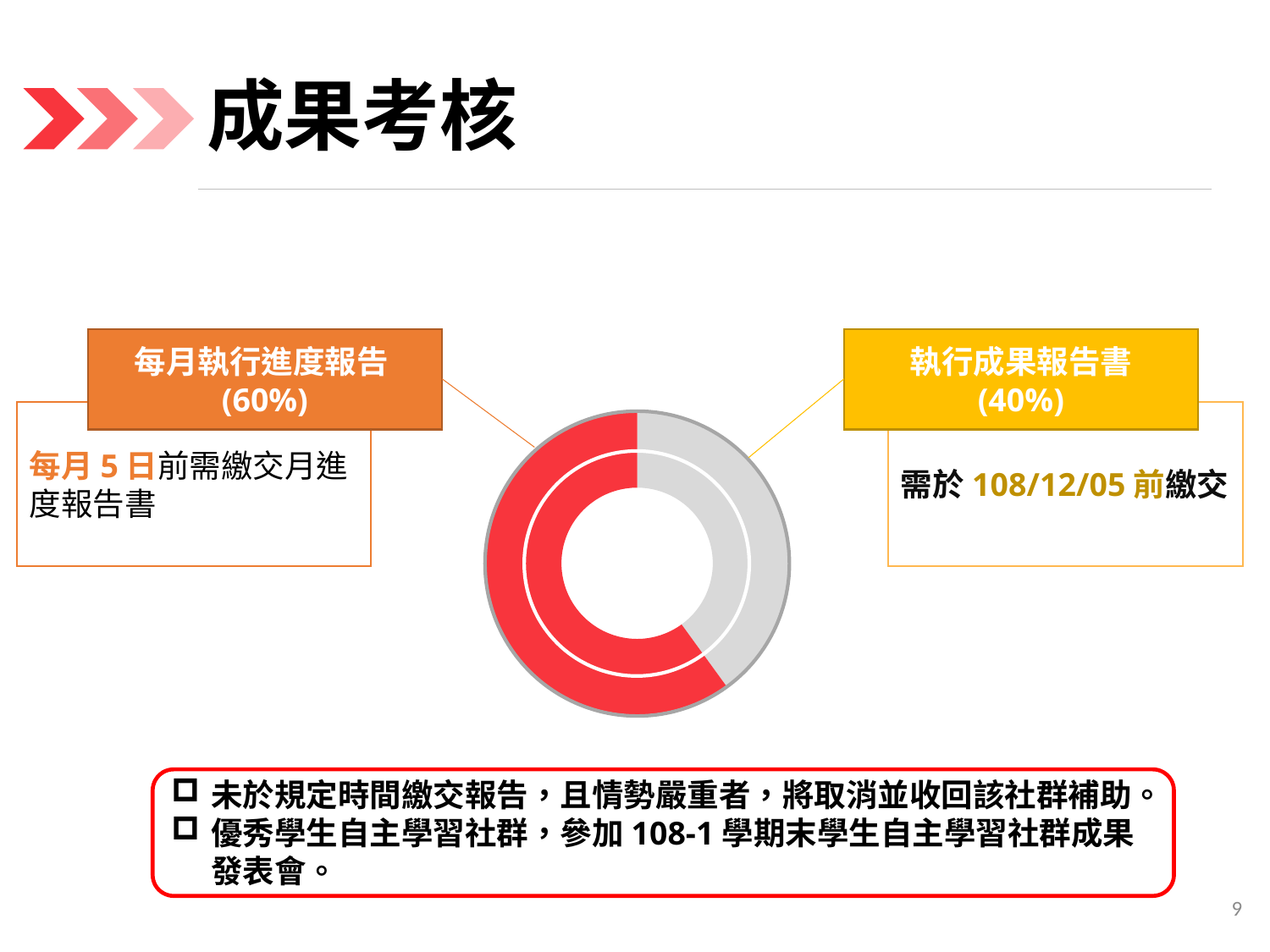
What is the difference in percentage points between 每月執行進度報告 and 執行成果報告書? 20 percentage points What colour is the segment representing 每月執行進度報告? Red What kind of chart is shown on the slide? Doughnut (pie) chart Which segment of the chart is the smallest? 執行成果報告書 What colour is the segment representing 執行成果報告書? Grey Is the share for 執行成果報告書 greater or less than 50%? less Which segment of the chart is the largest? 每月執行進度報告 What share of the chart does 每月執行進度報告 represent? 60% Which is larger, 每月執行進度報告 or 執行成果報告書? 每月執行進度報告 How many segments does the doughnut chart have? 2 What share of the chart does 執行成果報告書 represent? 40%